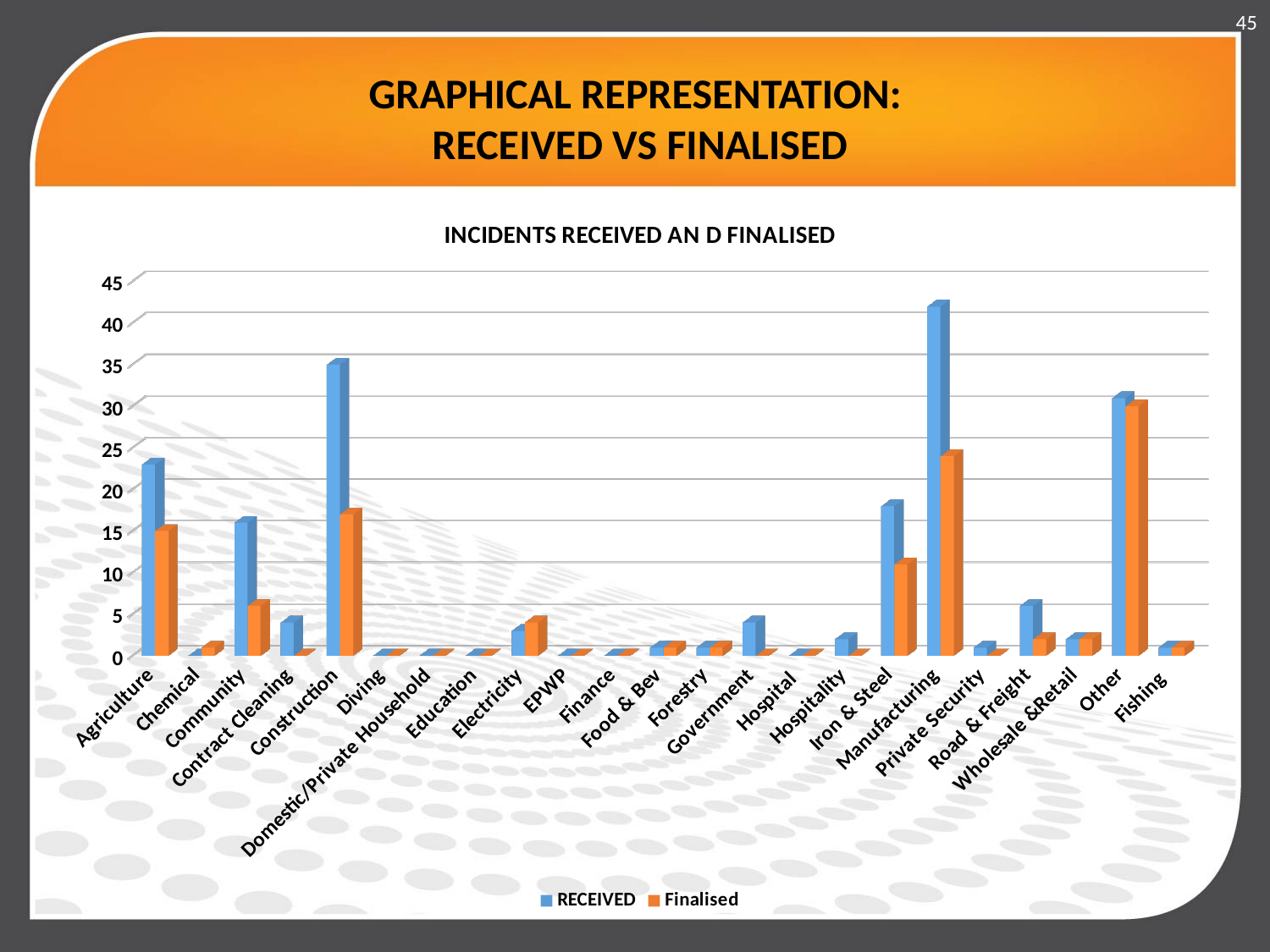
Which category has the highest RECEIVED value? Manufacturing Which is larger, the Finalised value for Other or the Finalised value for Manufacturing? Other How many categories are shown on the x axis? 23 What kind of chart is shown on the slide? bar chart Which is larger, the RECEIVED value for Construction or the RECEIVED value for Agriculture? Construction How many series does the legend list? 2 Which category has the highest Finalised value? Other Is the RECEIVED value for Iron & Steel greater or less than 20? less Is the Finalised value for Construction greater or less than 15? greater Which colour represents the Finalised series in the legend? orange Is the Finalised value for Manufacturing greater or less than 20? greater